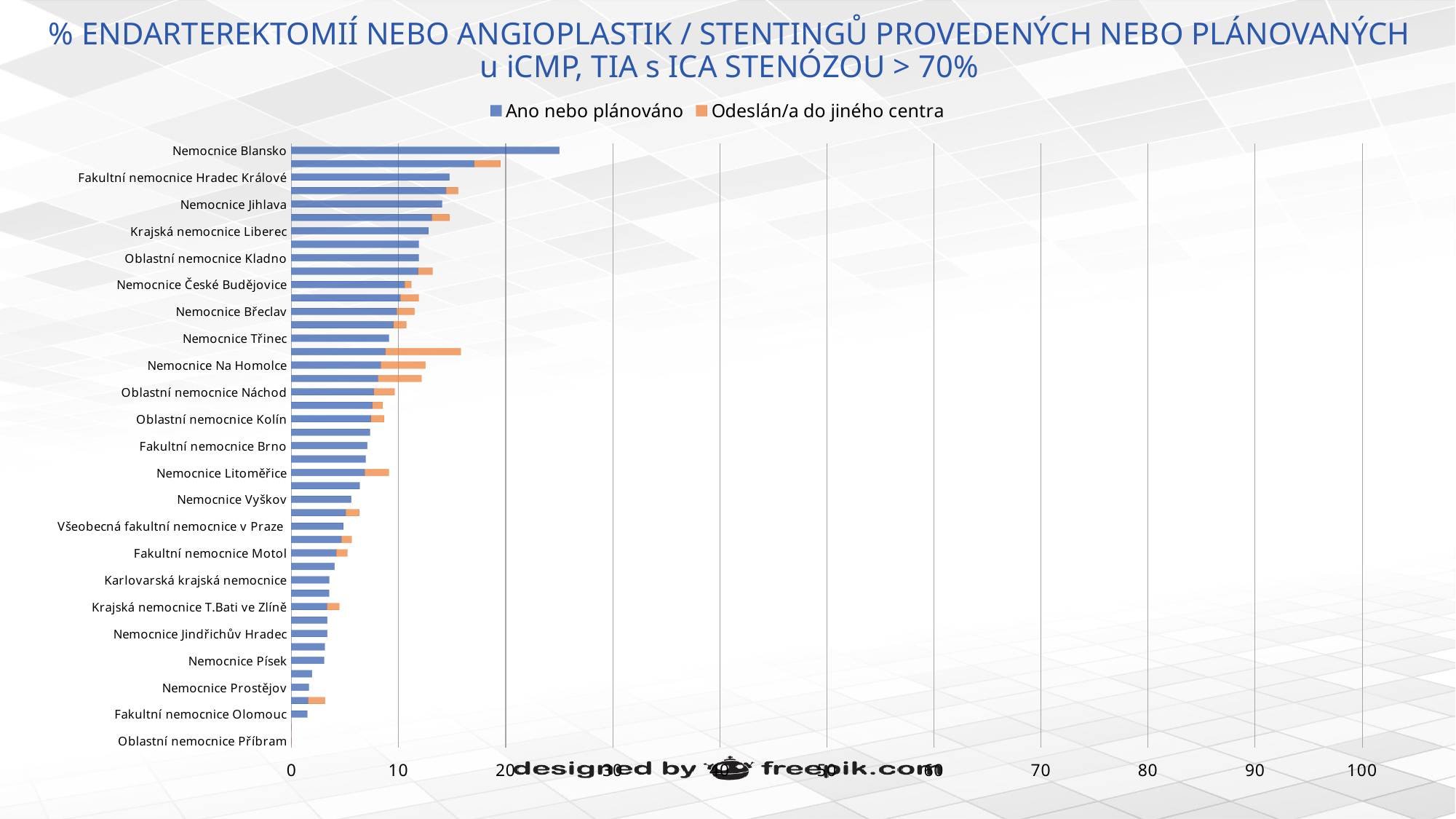
Which labelled hospital has the lowest value, with no visible bar? Oblastní nemocnice Příbram What kind of chart is shown on the slide? bar chart Do the bar lengths increase or decrease going from the top of the chart to the bottom? decrease Which has a larger 'Ano nebo plánováno' value, Nemocnice Blansko or Nemocnice Jihlava? Nemocnice Blansko Which series is shown in orange? Odeslán/a do jiného centra How many series does the legend list? 2 Which has a larger 'Ano nebo plánováno' value, Nemocnice Třinec or Nemocnice Písek? Nemocnice Třinec Is the 'Ano nebo plánováno' value for Nemocnice Blansko greater or less than 20? greater Is the 'Ano nebo plánováno' value for Nemocnice Vyškov greater or less than 10? less Which hospital has the highest value for 'Ano nebo plánováno'? Nemocnice Blansko Is the 'Ano nebo plánováno' value for Fakultní nemocnice Olomouc greater or less than 10? less